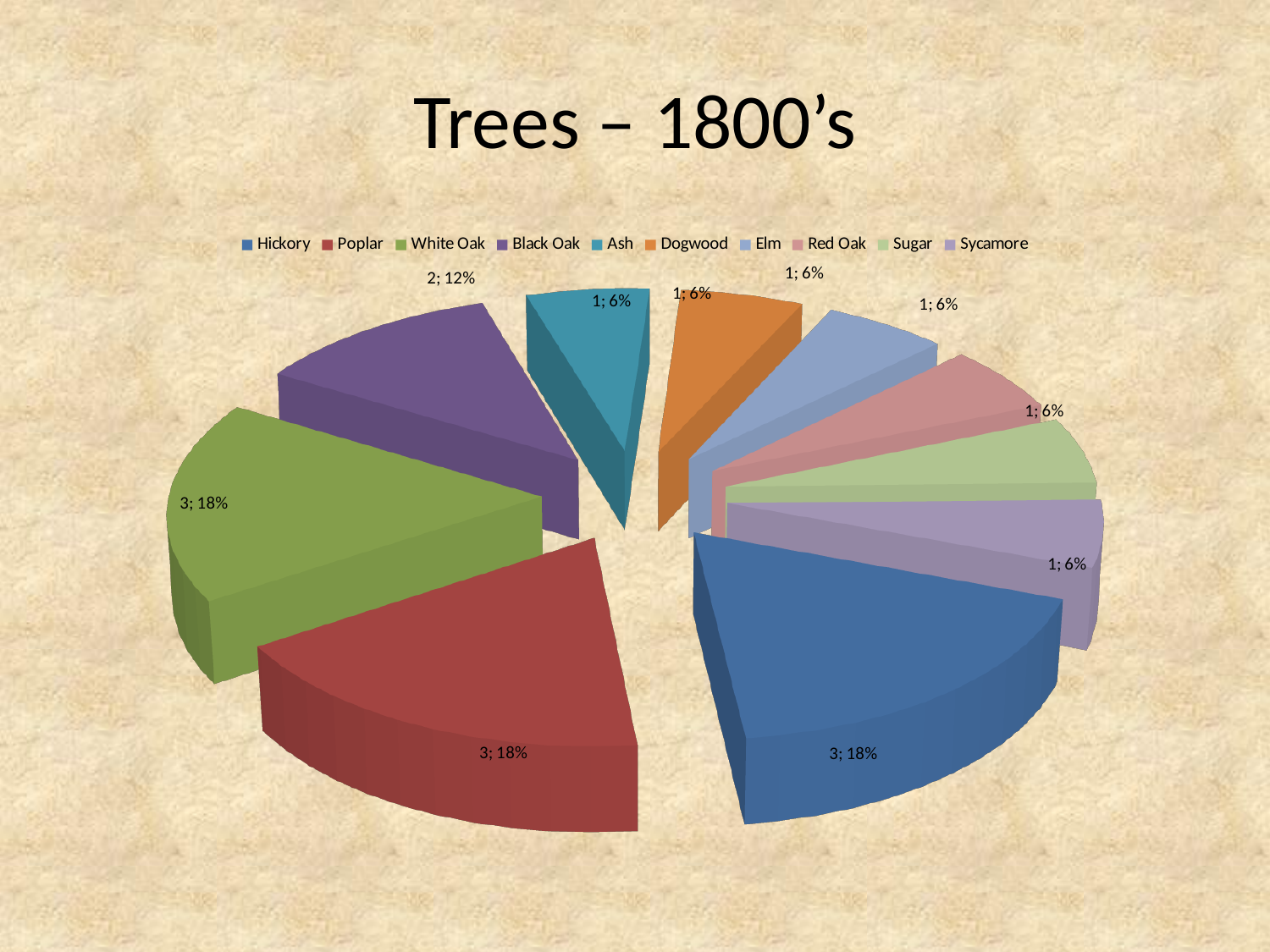
What is the value shown for Ash? 1 What is the difference between the value for Hickory and the value for Black Oak? 1 What share of the pie does Hickory represent? 18% What share of the pie does Black Oak represent? 12% Which is larger, the value for White Oak or the value for Black Oak? White Oak What kind of chart is shown on the slide? Pie chart Which is larger, the share for Black Oak or the share for Dogwood? Black Oak What is the title of the chart? Trees – 1800's What is the value shown for Black Oak? 2 What is the smallest percentage share shown on the pie? 6% What is the value shown for Poplar? 3 How many tree categories does the legend list? 10